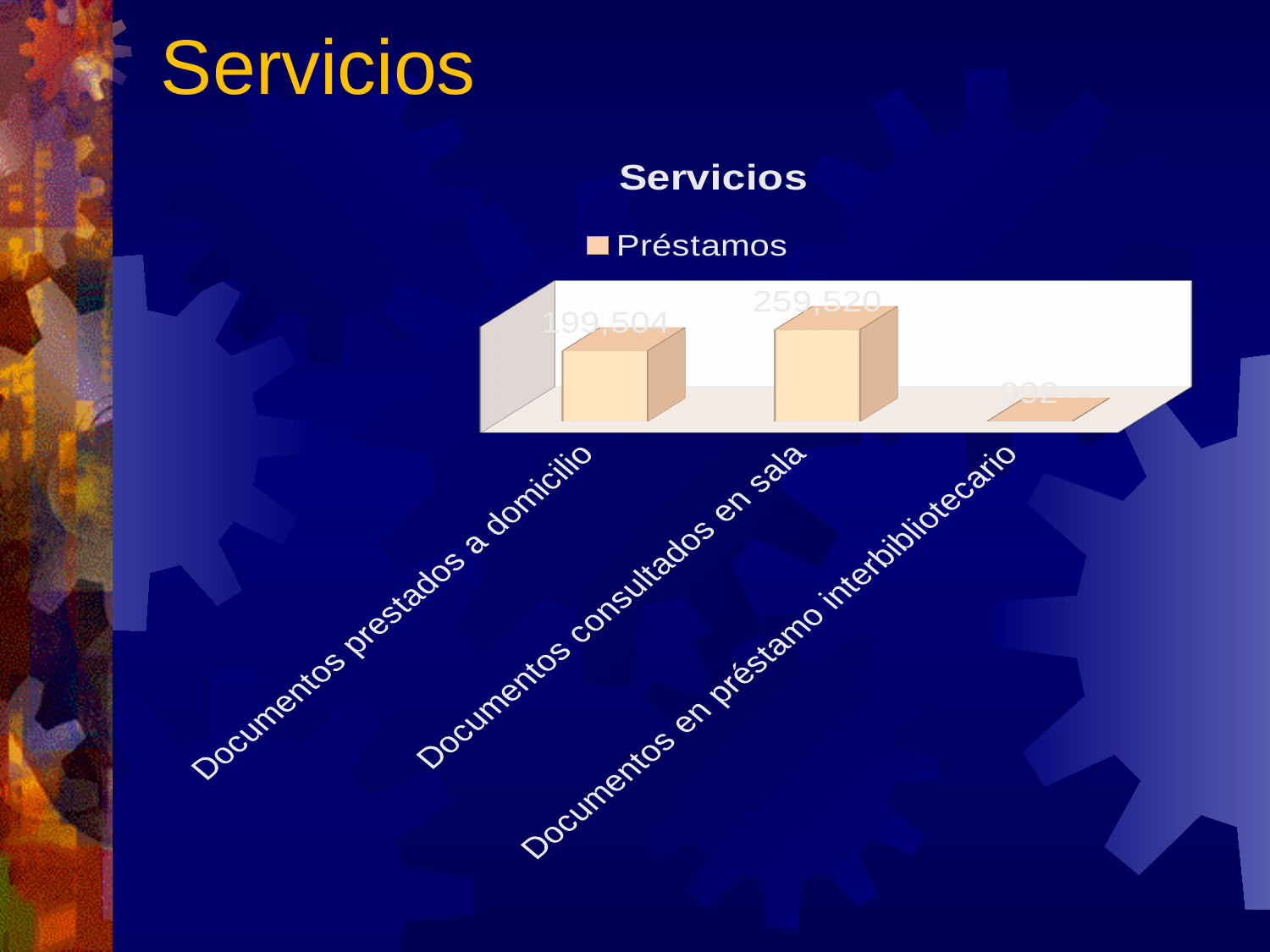
How many series does the legend list? 1 What is the value for Documentos en préstamo interbibliotecario? 992 Which category has the lowest value? Documentos en préstamo interbibliotecario What is the value for Documentos consultados en sala? 259,520 What is the value for Documentos prestados a domicilio? 199,504 What is the title of the chart? Servicios How many categories are shown in the chart? 3 What type of chart is shown on the slide? bar chart What series does the chart legend list? Préstamos What is the difference between the values for Documentos consultados en sala and Documentos prestados a domicilio? 60,016 Which is larger, the value for Documentos prestados a domicilio or the value for Documentos consultados en sala? Documentos consultados en sala Which category has the highest value? Documentos consultados en sala